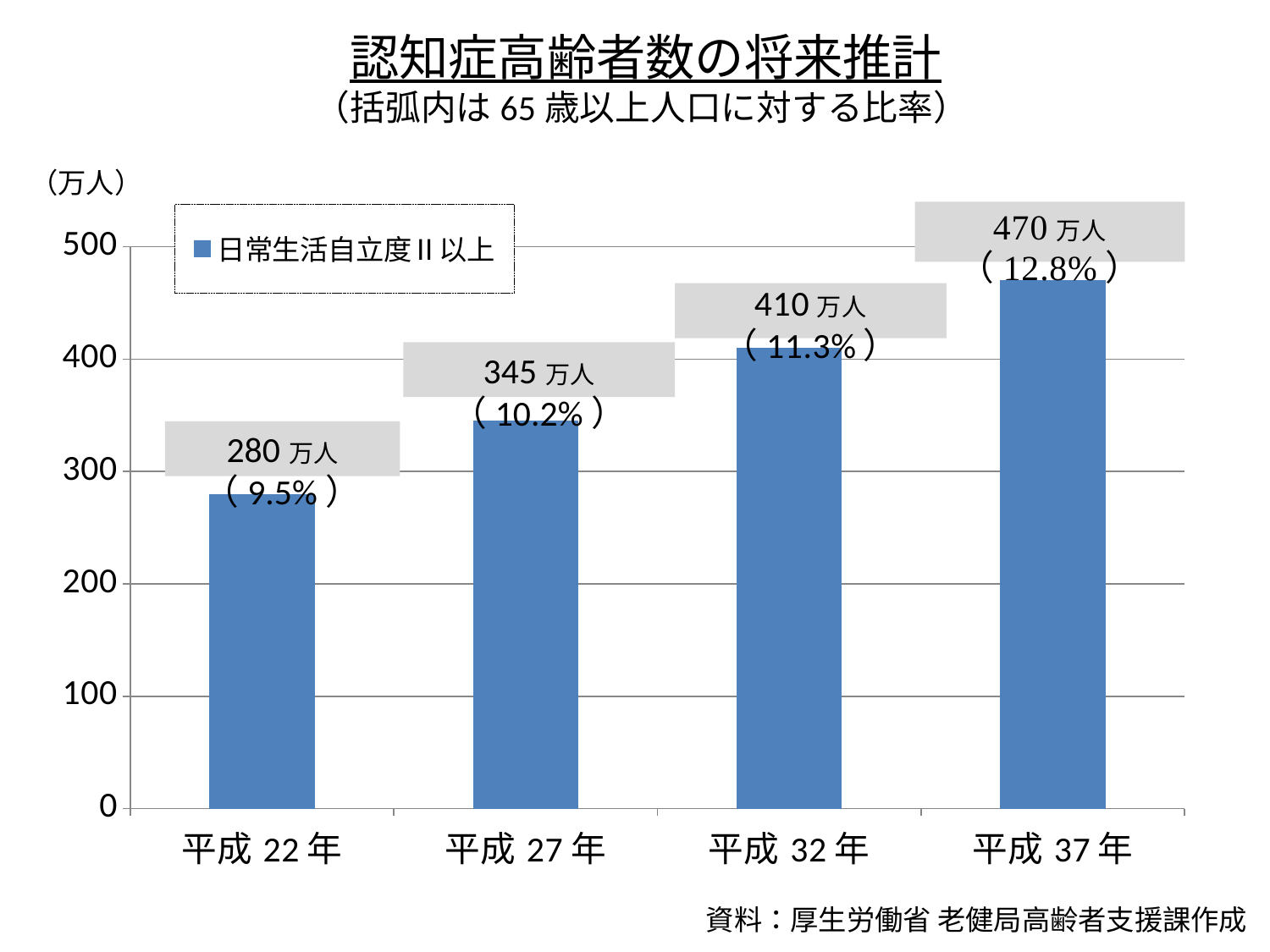
What is the value for 平成32年? 410万人 Which is larger, the value for 平成27年 or 平成32年? 平成32年 What is the difference between the values for 平成37年 and 平成22年? 190万人 Do the values rise or fall from 平成22年 to 平成37年? rise Which year has the lowest value? 平成22年 How many years are shown on the x axis? 4 What percentage of the population aged 65 and over is shown in parentheses for 平成37年? 12.8% Which year has the highest value? 平成37年 What kind of chart is this? bar chart What is the difference between the values for 平成27年 and 平成22年? 65万人 Is the value for 平成27年 greater or less than 300? greater What is the value for 平成22年? 280万人